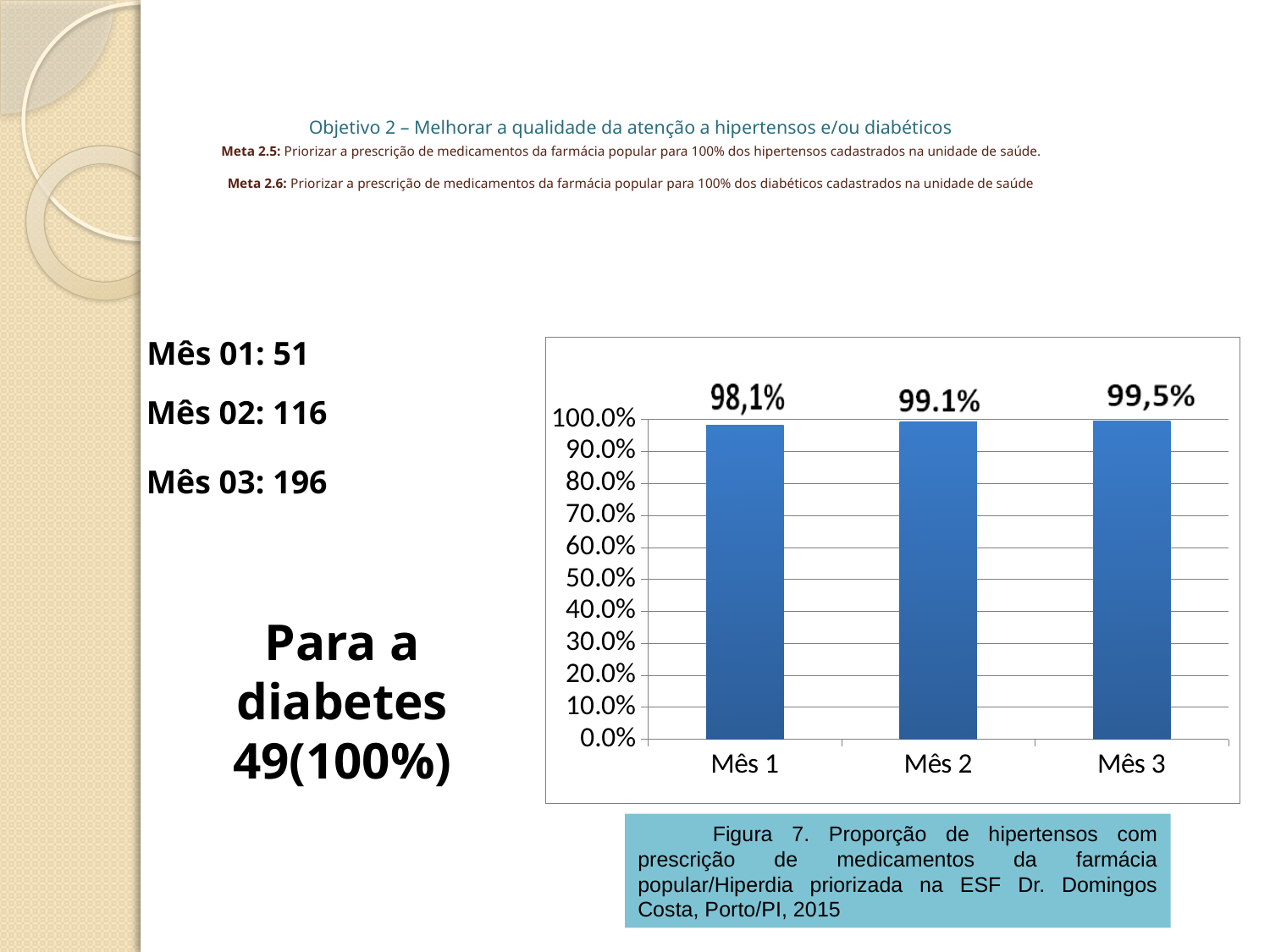
Is the value for Mês 1 greater or less than 90.0%? greater What is the value for Mês 1 in the chart? 98,1% Do the values rise or fall from Mês 1 to Mês 3? rise Which month has the highest value in the chart? Mês 3 What kind of chart is shown on the slide? bar chart Which is larger, the value for Mês 2 or the value for Mês 1? Mês 2 What is the value for Mês 3 in the chart? 99,5% What is the difference in percentage points between the values for Mês 3 and Mês 1? 1,4 How many months (categories) are shown in the chart? 3 What is the figure number given in the caption below the chart? Figura 7 Which month has the lowest value in the chart? Mês 1 What is the value for Mês 2 in the chart? 99.1%